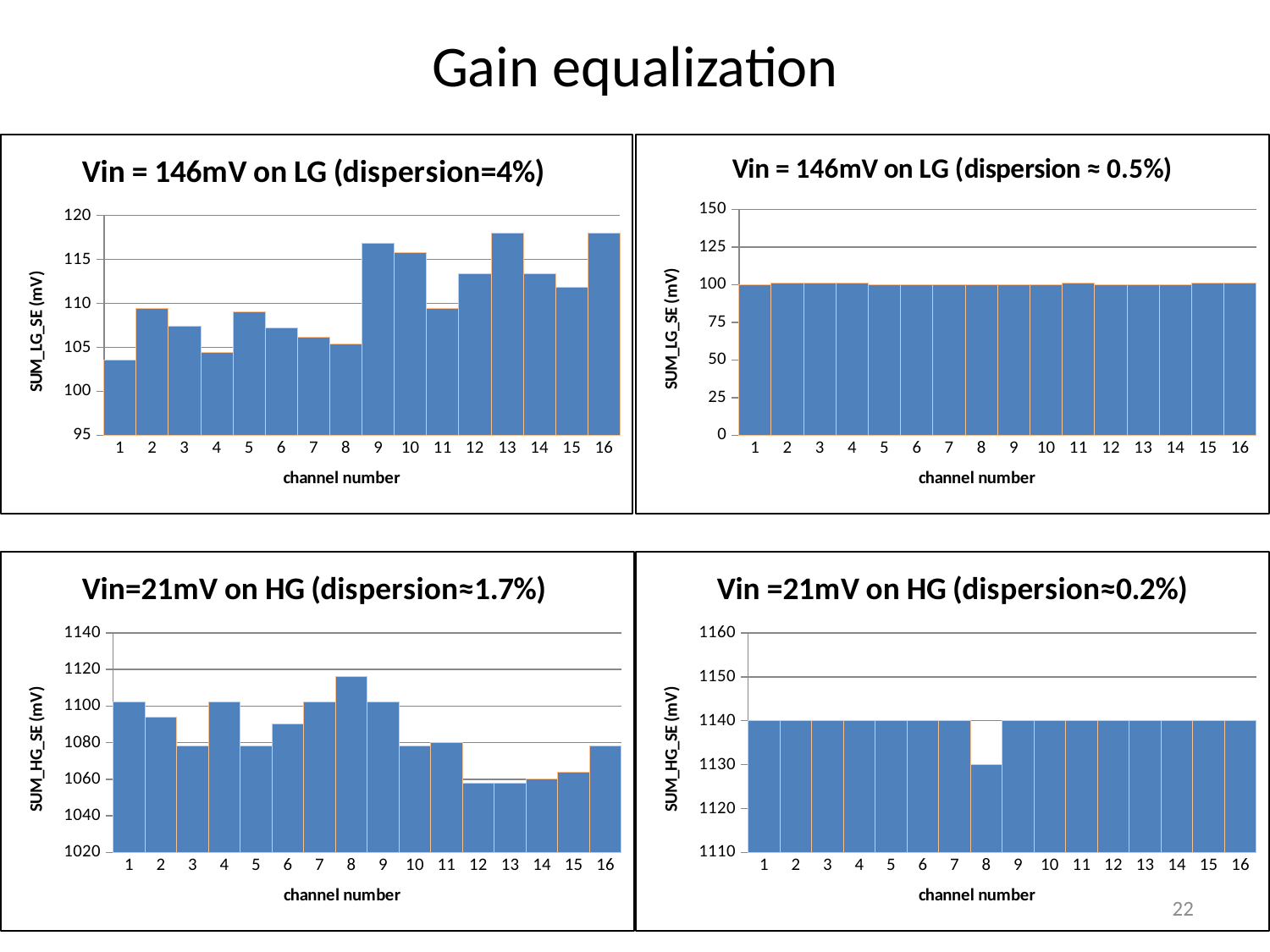
In the bottom-left chart 'Vin=21mV on HG (dispersion≈1.7%)', which channel has the highest value? 8 In the bottom-right chart 'Vin =21mV on HG (dispersion≈0.2%)', what is the value for channel 8? 1130 In the bottom-right chart 'Vin =21mV on HG (dispersion≈0.2%)', which is larger, the value for channel 8 or channel 9? channel 9 In the top-right chart 'Vin = 146mV on LG (dispersion ≈ 0.5%)', is the value for channel 5 greater or less than 125? less In the bottom-right chart 'Vin =21mV on HG (dispersion≈0.2%)', which channel has the lowest value? 8 How many channels are plotted in the top-left chart 'Vin = 146mV on LG (dispersion=4%)'? 16 In the bottom-left chart 'Vin=21mV on HG (dispersion≈1.7%)', is the value for channel 14 greater or less than 1080? less In the top-left chart 'Vin = 146mV on LG (dispersion=4%)', is the value for channel 9 greater or less than 115? greater What kind of chart is the top-left chart titled 'Vin = 146mV on LG (dispersion=4%)'? bar chart What is the y-axis label of the top-right chart 'Vin = 146mV on LG (dispersion ≈ 0.5%)'? SUM_LG_SE (mV)